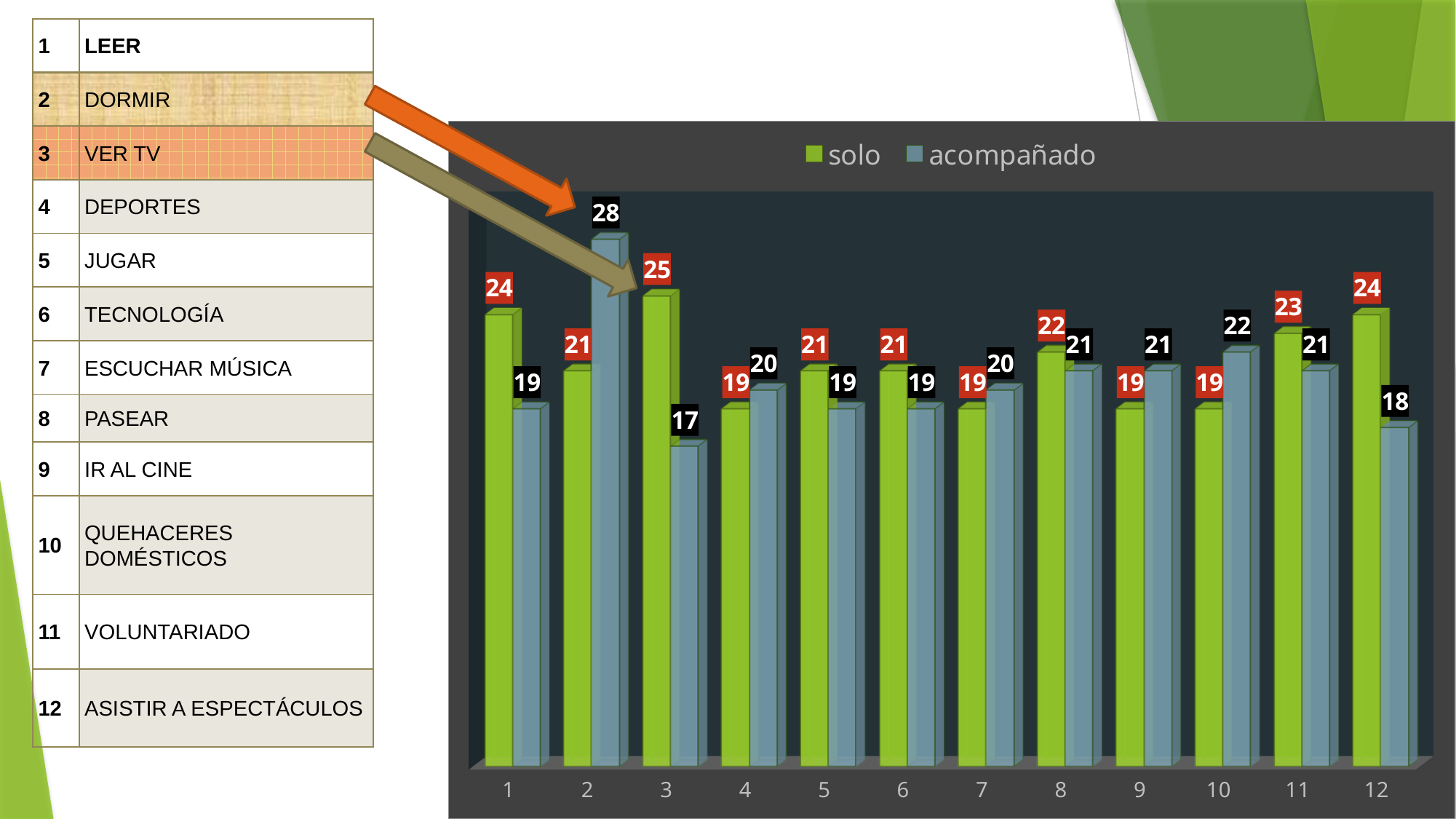
What is the value of the 'acompañado' series for category 2? 28 What is the value of the 'acompañado' series for category 12? 18 Which category has the highest 'solo' value? 3 How many series does the chart legend list? 2 What kind of chart is shown on the slide? bar chart Which category has the lowest 'acompañado' value? 3 What is the difference between the 'solo' and 'acompañado' values for category 3? 8 What is the value of the 'solo' series for category 3? 25 What is the difference between the 'acompañado' and 'solo' values for category 2? 7 How many categories are shown on the x axis of the chart? 12 For category 10, which series has the larger value, 'solo' or 'acompañado'? acompañado Which category has the highest 'acompañado' value? 2